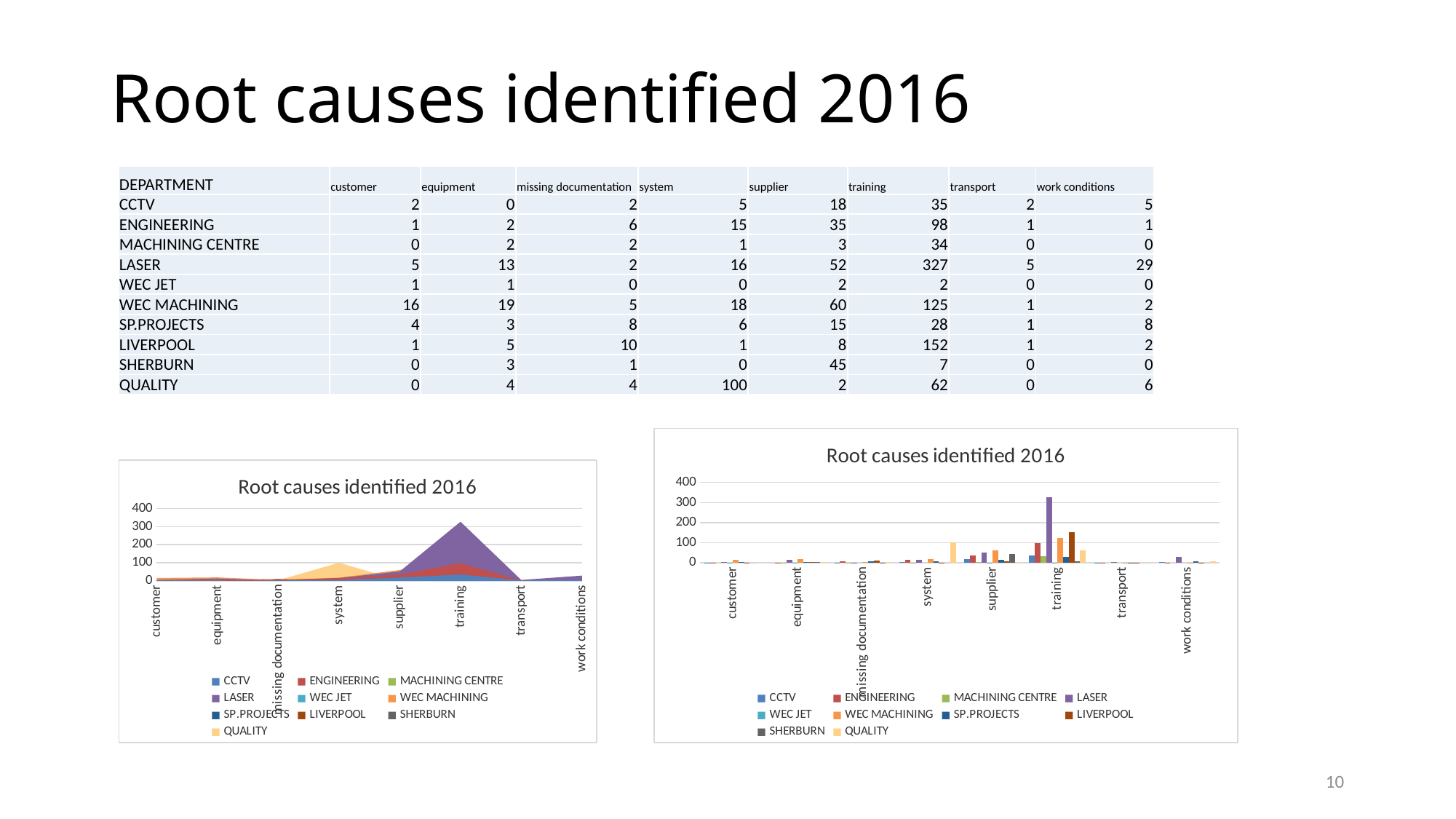
What kind of chart is the left chart on the slide? area chart In the right chart, what is the difference between the LASER and LIVERPOOL values in the training category? 175 In the right chart, what is the value for LASER in the training category? 327 In the right chart, which category contains the tallest bar? training In the right chart, what is the value for QUALITY in the system category? 100 How many series does the legend of the right chart list? 10 In the left chart, is the value for QUALITY in the system category greater or less than 50? greater What kind of chart is the right chart on the slide? bar chart How many categories are shown along the x axis of the right chart? 8 In the right chart, which is larger in the training category: LASER or LIVERPOOL? LASER What is the title of the right chart? Root causes identified 2016 In the right chart, is the value for LASER in the training category greater or less than 300? greater